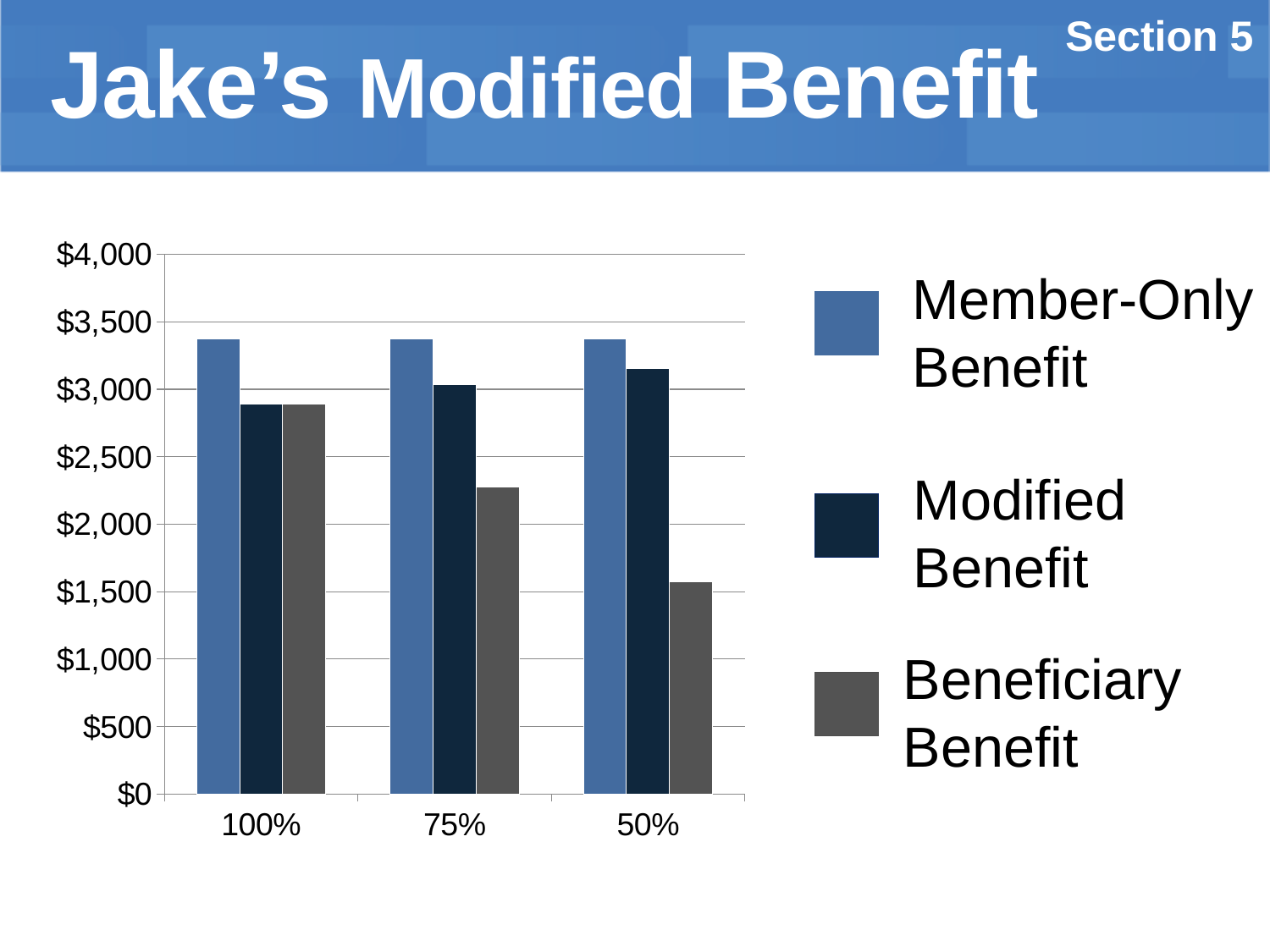
Is the Modified Benefit value at 100% greater or less than $3,000? less Is the Beneficiary Benefit value at 75% greater or less than $2,000? greater At 75%, which is larger: the Modified Benefit or the Beneficiary Benefit? Modified Benefit Is the Beneficiary Benefit value at 50% greater or less than $2,000? less How many series does the legend list? 3 What is the title of the chart slide? Jake's Modified Benefit Does the Beneficiary Benefit rise or fall moving from 100% to 50% along the x axis? fall At which category is the Beneficiary Benefit lowest? 50% How many categories are shown on the x axis of the chart? 3 Which is larger: the Beneficiary Benefit at 100% or the Beneficiary Benefit at 50%? Beneficiary Benefit at 100% What kind of chart is shown on the slide? bar chart